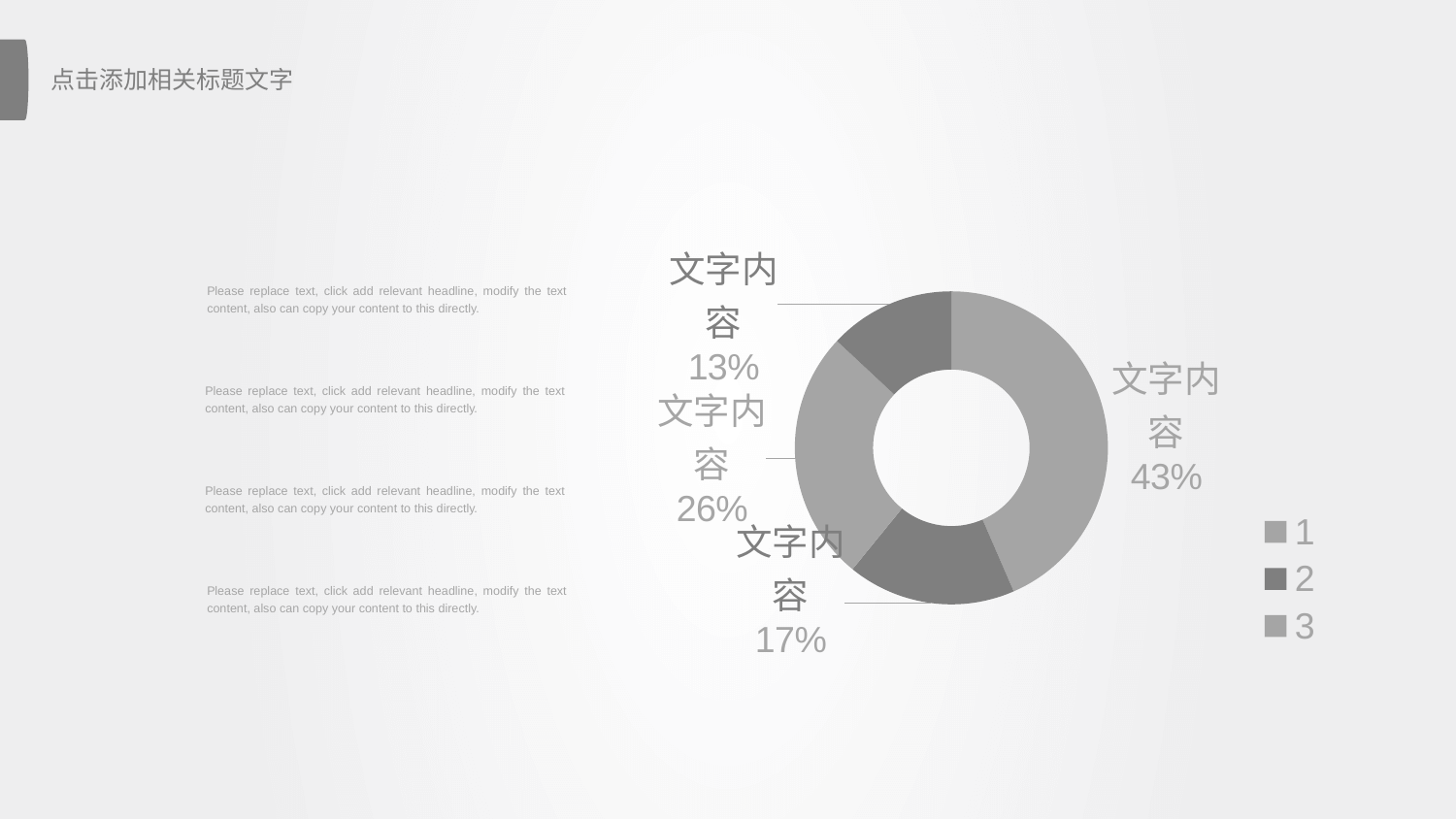
What is the difference in percentage points between the largest slice (43%) and the smallest slice (13%)? 30 Which is larger, the slice labelled 26% or the slice labelled 17%? 26% How many slices does the doughnut chart have? 4 What is the smallest percentage shown on the doughnut chart? 13% What percentage is labelled on the slice at the left side of the doughnut chart? 26% How many entries does the legend of the doughnut chart list? 3 What percentage is labelled on the slice at the right side of the doughnut chart? 43% What percentage is labelled on the slice at the bottom of the doughnut chart? 17% What is the largest percentage shown on the doughnut chart? 43% What kind of chart is shown on the slide? doughnut chart What are the entries listed in the legend of the doughnut chart? 1, 2, 3 What percentage is labelled on the darkest slice at the top-left of the doughnut chart? 13%